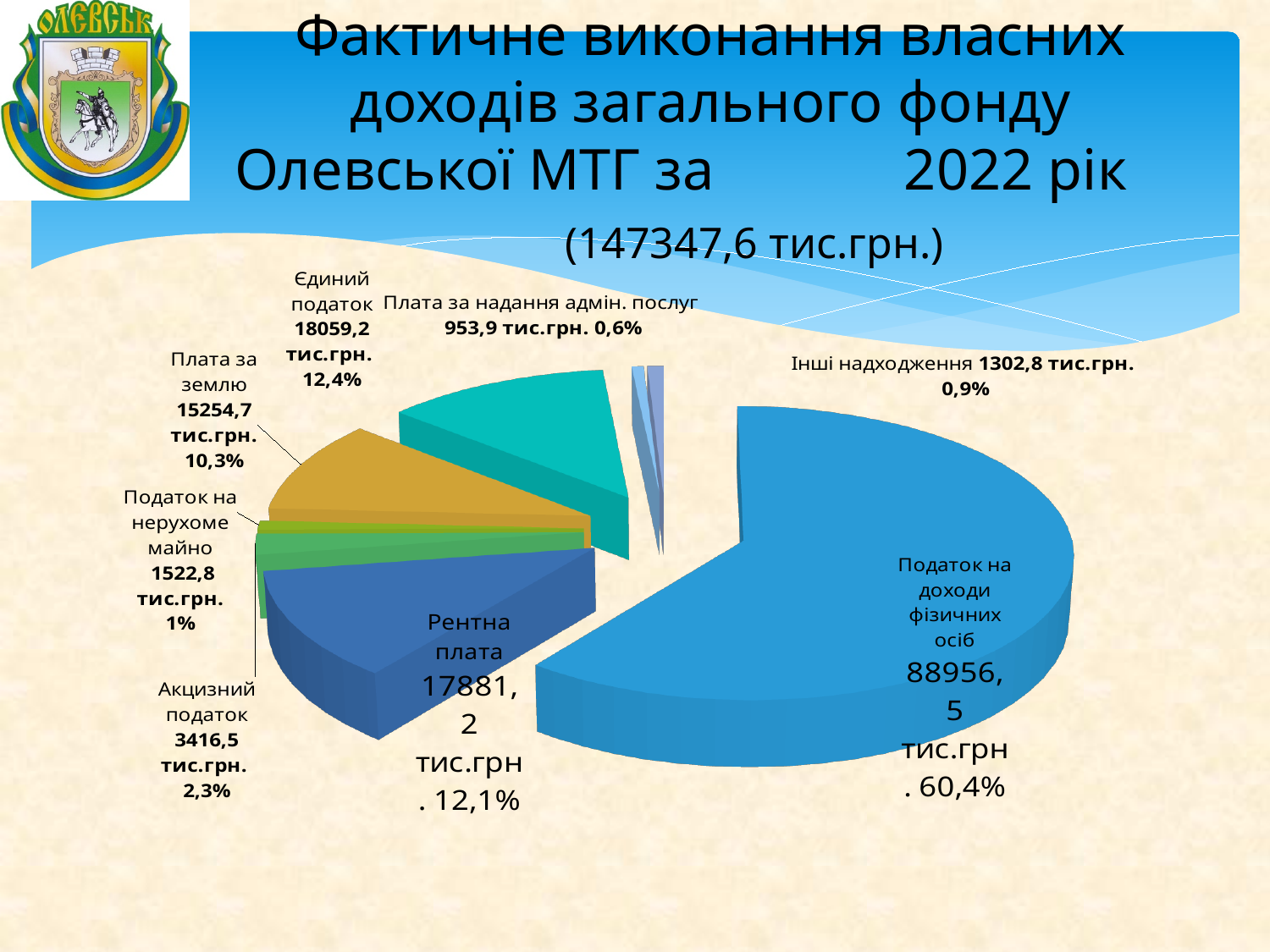
What is the value for Податок на доходи фізичних осіб? 88956,5 тис.грн. Which category has the smallest slice of the pie? Плата за надання адмін. послуг What is the value for Інші надходження? 1302,8 тис.грн. What share of the pie does Податок на доходи фізичних осіб represent? 60,4% How many slices (categories) does the pie chart have? 8 What is the difference between Акцизний податок and Податок на нерухоме майно in тис.грн.? 1893,7 тис.грн. Which category has the largest slice of the pie? Податок на доходи фізичних осіб Which is larger, Єдиний податок or Рентна плата? Єдиний податок What total amount is stated in the chart title for 2022? 147347,6 тис.грн. What share of the pie does Плата за землю represent? 10,3% What is the value for Єдиний податок? 18059,2 тис.грн. What kind of chart is shown on the slide? Pie chart